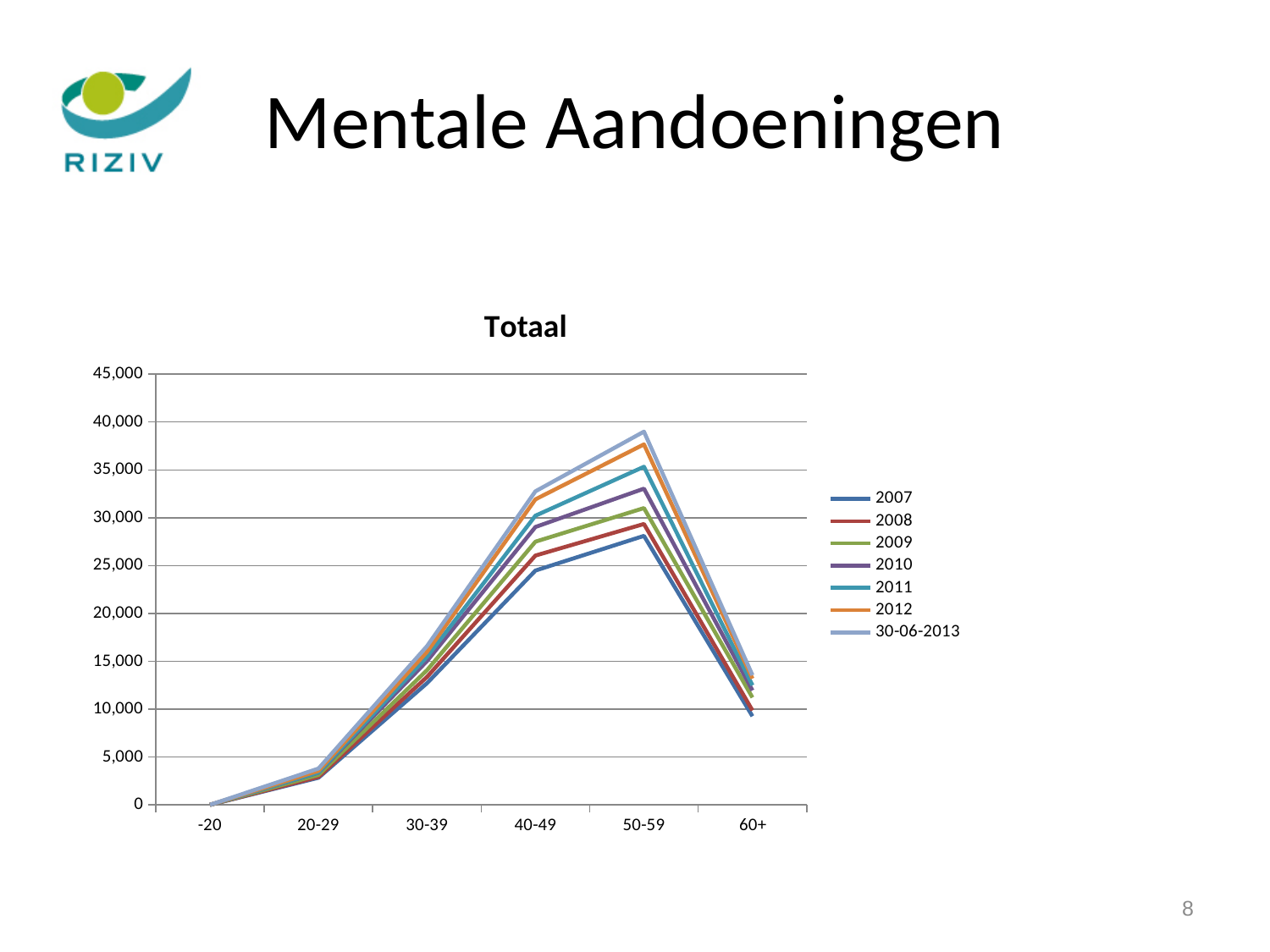
What kind of chart is shown on the slide? line chart For the 30-06-2013 series, which age group has the lowest value? -20 Is the value for the 30-06-2013 series at 50-59 greater or less than 40,000? less At the 50-59 age group, which series has the larger value, 2007 or 30-06-2013? 30-06-2013 For the 2007 series, which age group has the highest value? 50-59 Do the values of the 2011 series rise or fall from the 50-59 age group to the 60+ age group? fall Is the value for the 2012 series at 40-49 greater or less than 30,000? greater Is the value for the 2007 series at 50-59 greater or less than 25,000? greater What is the title of the chart? Totaal Which legend entry is listed last in the chart's legend? 30-06-2013 How many age-group categories are shown on the x axis of the chart? 6 How many series does the legend of the chart list? 7